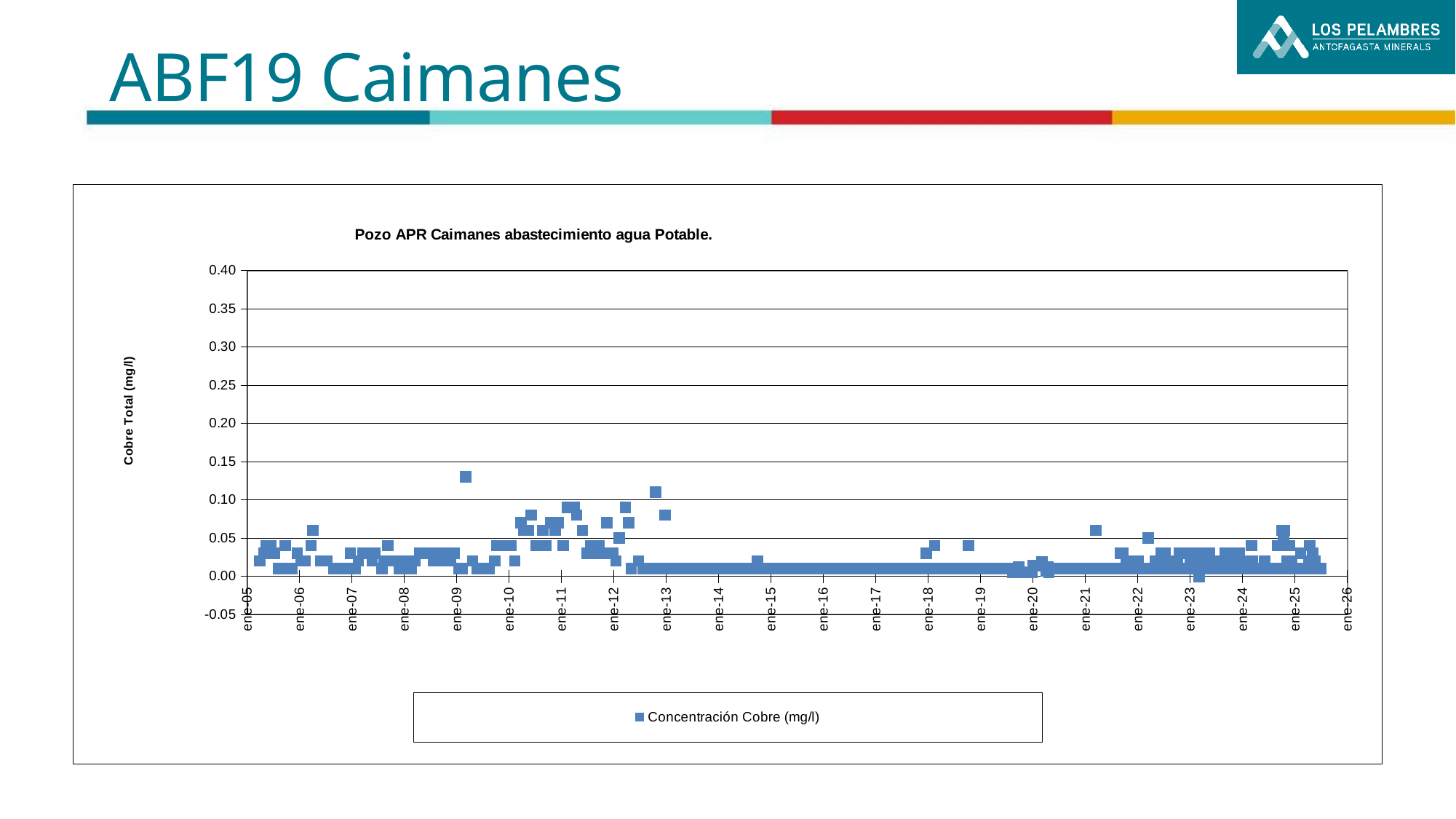
In which year does the highest plotted point occur? 2009 What is the label on the vertical axis of the chart? Cobre Total (mg/l) Is the highest plotted value in the chart greater or less than 0.10? greater What kind of chart is shown on the slide? scatter chart Are the plotted values between ene-14 and ene-17 greater or less than 0.00? greater Are the plotted values between ene-14 and ene-17 greater or less than 0.05? less How many series does the chart legend list? 1 What is the title of the chart? Pozo APR Caimanes abastecimiento agua Potable.